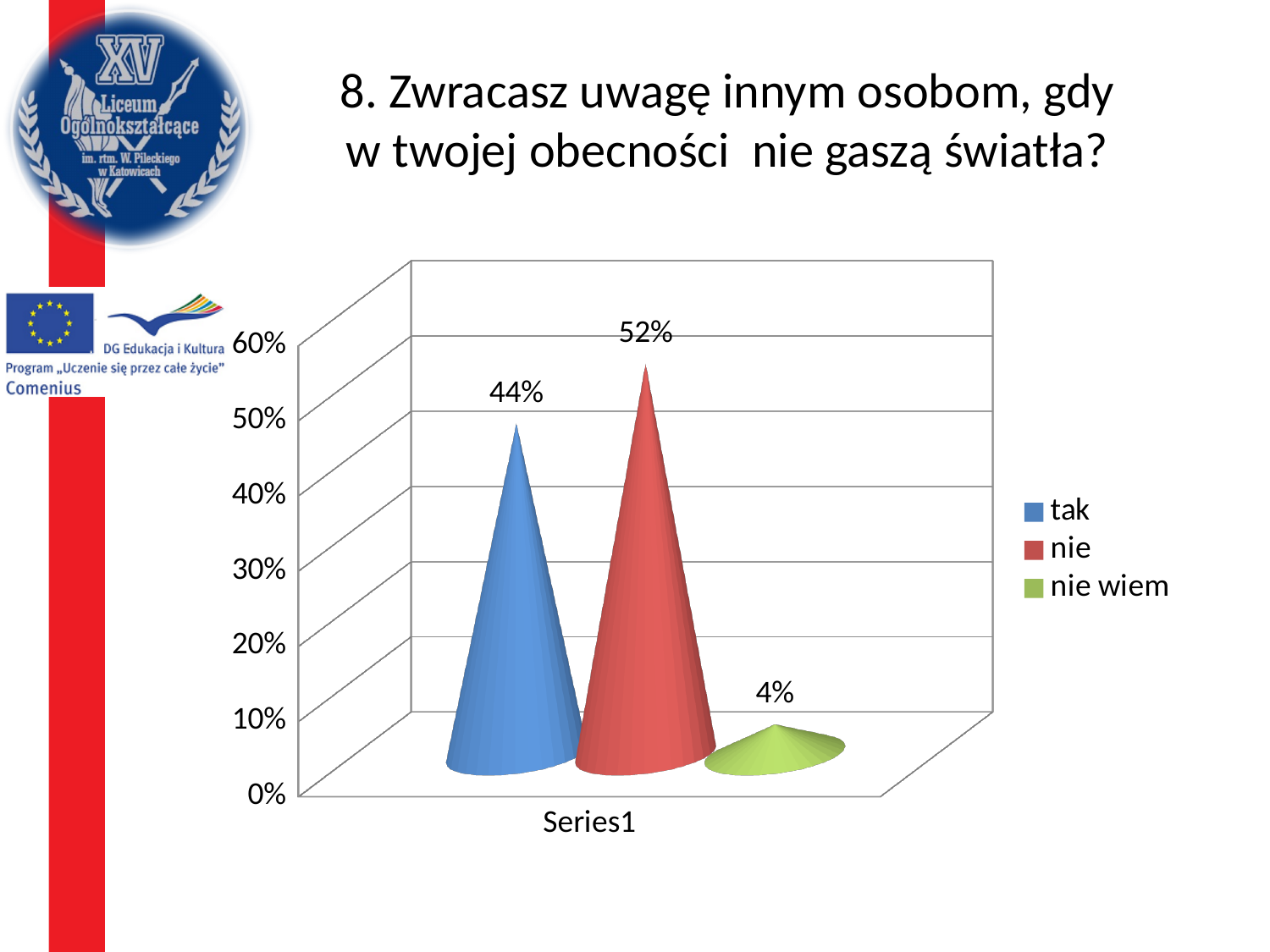
Which is larger, the value for "tak" or the value for "nie"? nie Which category has the highest value? nie What is the difference between the values for "nie" and "tak"? 8% What is the label shown on the horizontal axis of the chart? Series1 Which category has the lowest value? nie wiem How many series does the legend list? 3 Is the value for "tak" greater or less than 40%? greater What colour is the "nie" series in the legend? red What is the value for "nie wiem"? 4% What is the value for "tak"? 44% What is the value for "nie"? 52% What kind of chart is shown on the slide? bar chart